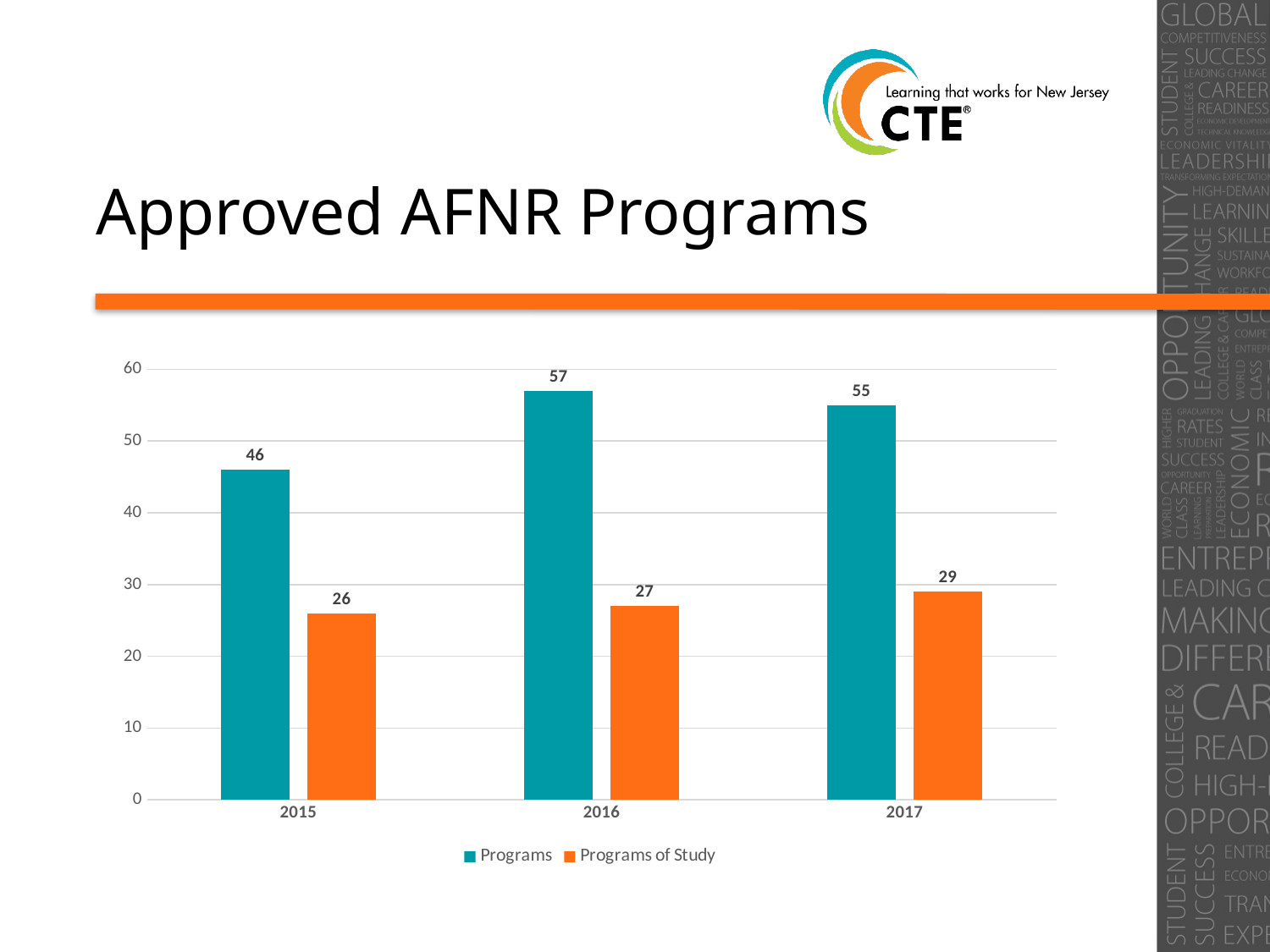
How many series does the legend list? 2 Which year has the lowest value for Programs of Study? 2015 What is the value for Programs of Study in 2015? 26 What kind of chart is shown on the slide? Bar chart Is the value for Programs in 2015 greater or less than 40? greater How many years are shown on the x axis? 3 Which is larger: Programs in 2015 or Programs in 2017? Programs in 2017 What is the value for Programs of Study in 2017? 29 Which year has the highest value for Programs? 2016 What is the value for Programs in 2016? 57 Do the values for Programs of Study rise or fall from 2015 to 2017? Rise What is the difference between Programs and Programs of Study in 2017? 26